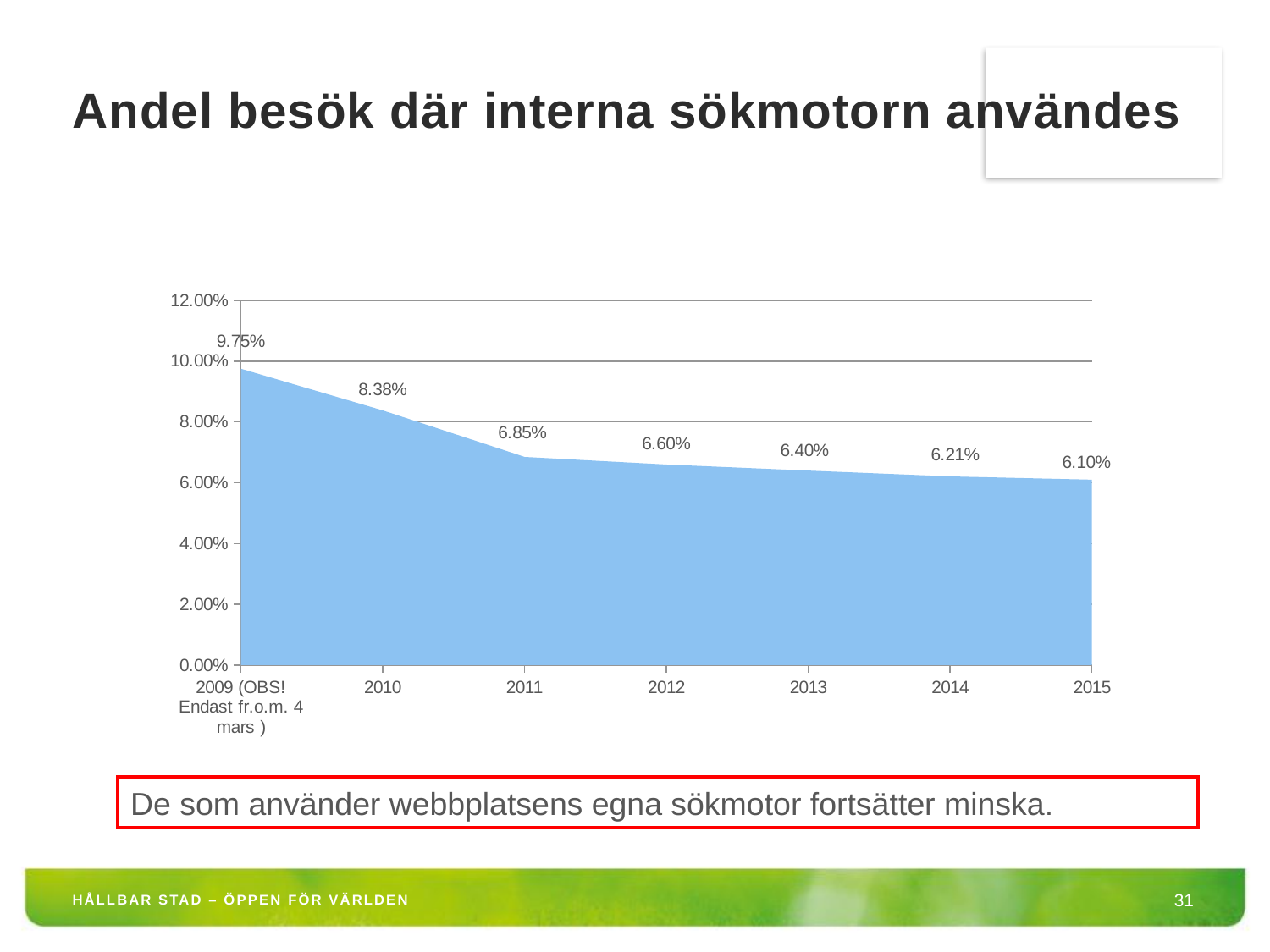
Do the values rise or fall from 2009 to 2015? fall Which is larger, the value for 2012 or the value for 2014? 2012 What is the value for 2013? 6.40% What is the value for 2010? 8.38% What is the difference between the 2009 value and the 2015 value? 3.65% Is the value for 2011 greater or less than 8.00%? less Which year has the highest value? 2009 How many years are plotted on the x axis? 7 Which year has the lowest value? 2015 What kind of chart is shown on the slide? area chart What is the difference between the 2010 value and the 2011 value? 1.53% What is the value for 2015? 6.10%